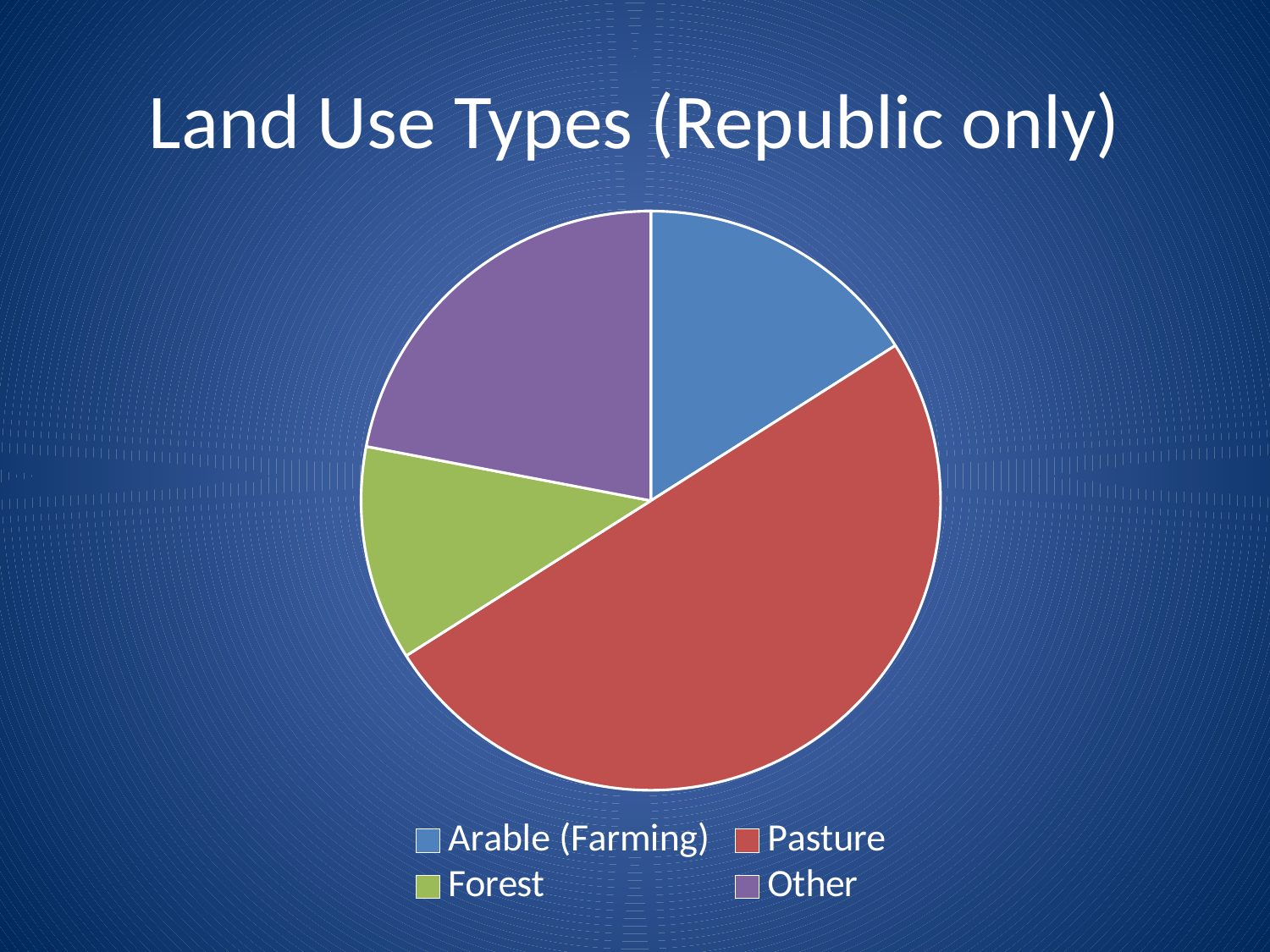
What kind of chart is shown on the slide? pie chart Which slice is larger, Forest or Pasture? Pasture Which land use type has the largest slice of the pie? Pasture What colour represents Pasture in the pie chart? red Which slice is larger, Pasture or Other? Pasture Which slice is larger, Other or Arable (Farming)? Other How many slices does the pie chart have? 4 What is the title of the chart? Land Use Types (Republic only) Which land use type has the smallest slice of the pie? Forest How many entries does the legend list? 4